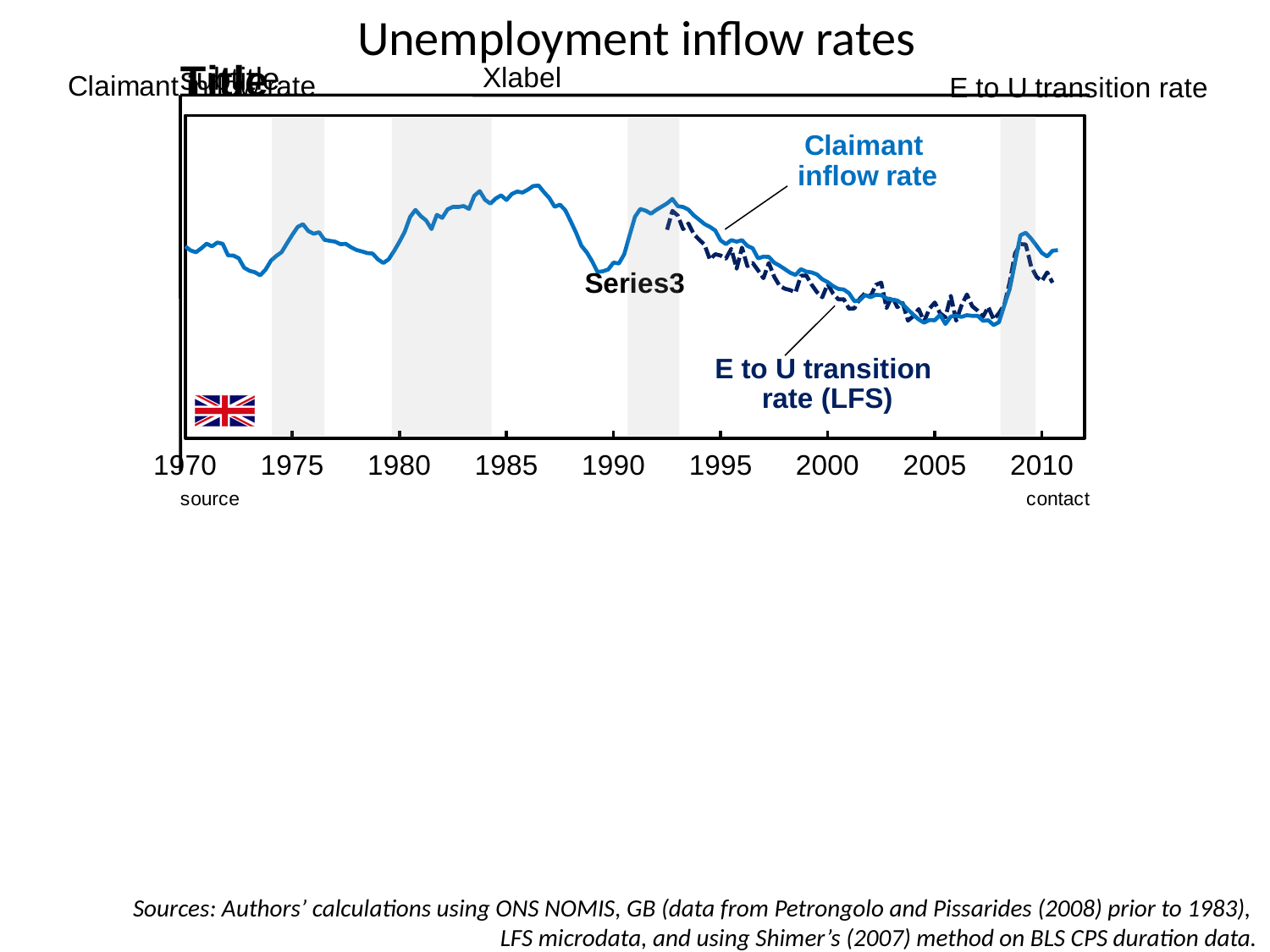
What is the title of the chart? Unemployment inflow rates Which series is drawn as a dashed line? E to U transition rate (LFS) What is the first year labelled on the x axis? 1970 Around 1993, which series is higher, the Claimant inflow rate or the E to U transition rate (LFS)? Claimant inflow rate Does the Claimant inflow rate rise or fall between 1986 and 1990? fall Which series begins earlier on the x axis, the Claimant inflow rate or the E to U transition rate (LFS)? Claimant inflow rate Does the Claimant inflow rate rise or fall overall between 1993 and 2004? fall What is the last year labelled on the x axis? 2010 What kind of chart is shown on the slide? line chart How many year labels are shown on the x axis? 9 Does the Claimant inflow rate rise or fall between 2007 and 2009? rise